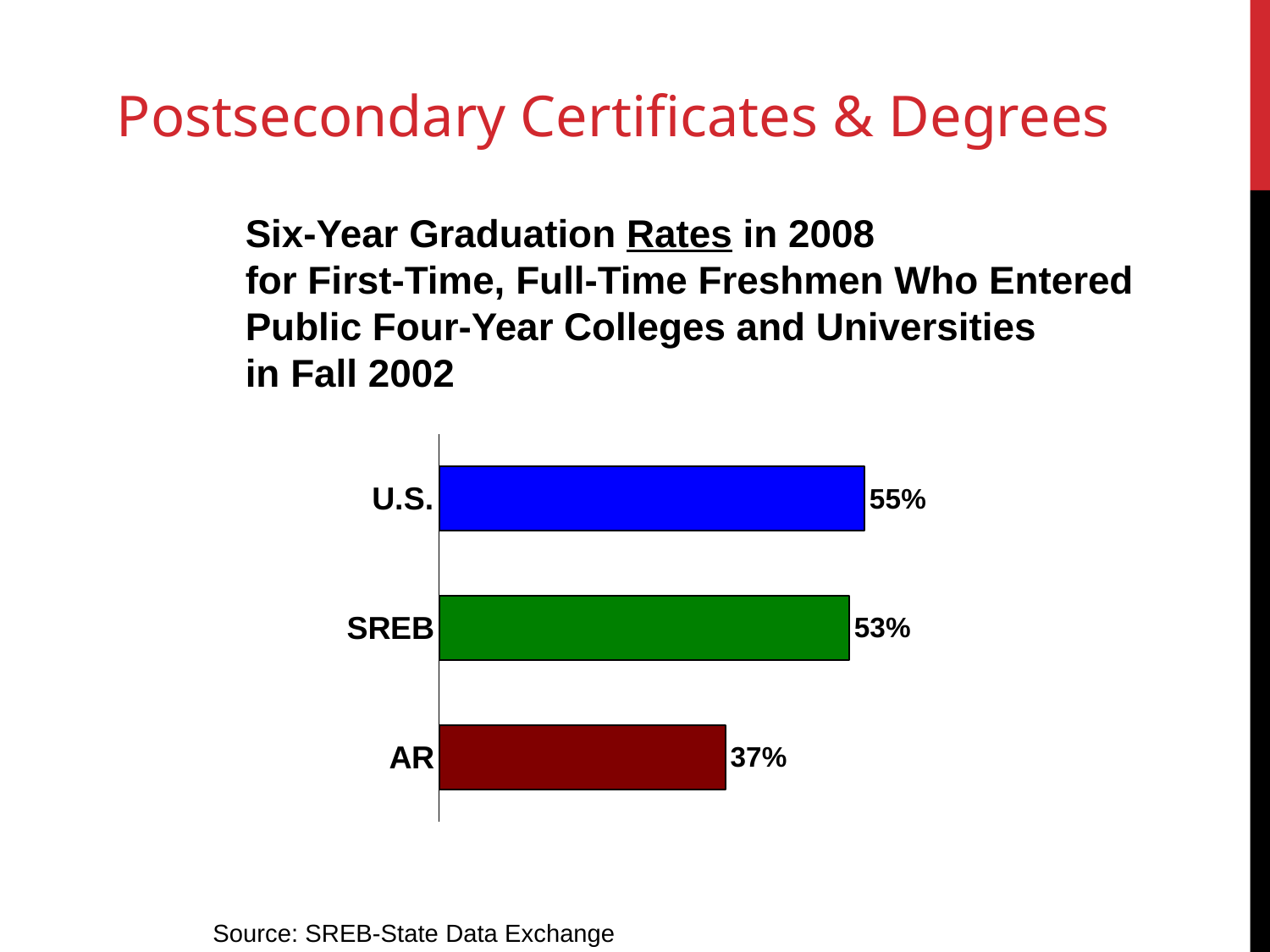
What is the difference between the U.S. rate and the SREB rate? 2% What is the six-year graduation rate shown for AR? 37% Which category has the highest graduation rate? U.S. Which is larger, the rate for SREB or the rate for AR? SREB Which category has the lowest graduation rate? AR What kind of chart is shown on the slide? Bar chart What is the six-year graduation rate shown for the U.S.? 55% What is the difference between the U.S. rate and the AR rate? 18% What colour is the bar for AR? Dark red What is the six-year graduation rate shown for SREB? 53% How many categories are shown in the chart? 3 What is the difference between the SREB rate and the AR rate? 16%